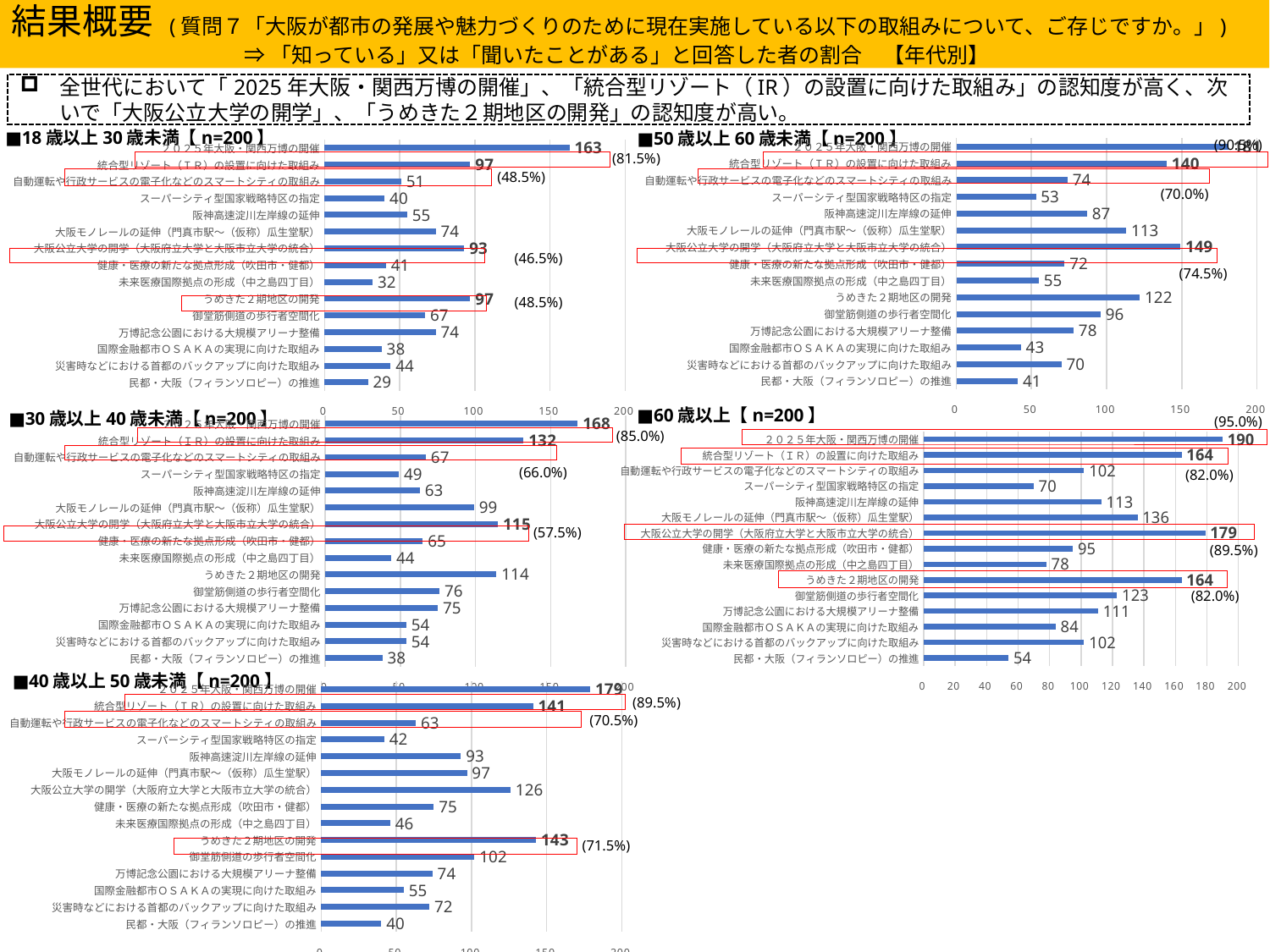
In the 「30歳以上40歳未満」 chart, what is the difference between 「2025年大阪・関西万博の開催」 and 「大阪公立大学の開学（大阪府立大学と大阪市立大学の統合）」? 53 In the 「40歳以上50歳未満」 chart, which is larger: 「阪神高速淀川左岸線の延伸」 or 「大阪モノレールの延伸（門真市駅～（仮称）瓜生堂駅）」? 大阪モノレールの延伸（門真市駅～（仮称）瓜生堂駅） In the 「50歳以上60歳未満」 chart, which category has the highest value? 2025年大阪・関西万博の開催 In the 「30歳以上40歳未満」 chart, what is the value for 「統合型リゾート（ＩＲ）の設置に向けた取組み」? 132 How many categories are plotted in the 「60歳以上」 chart? 15 In the 「18歳以上30歳未満」 chart, which category has the lowest value? 民都・大阪（フィランソロピー）の推進 In the 「50歳以上60歳未満」 chart, what is the value for 「大阪公立大学の開学（大阪府立大学と大阪市立大学の統合）」? 149 In the 「40歳以上50歳未満」 chart, what is the value for 「うめきた２期地区の開発」? 143 What type of chart is used for the 「18歳以上30歳未満」 age group? Bar chart In the 「60歳以上」 chart, what is the value for 「2025年大阪・関西万博の開催」? 190 In the 「60歳以上」 chart, what is the difference between 「統合型リゾート（ＩＲ）の設置に向けた取組み」 and 「民都・大阪（フィランソロピー）の推進」? 110 In the 「18歳以上30歳未満」 chart, what is the value for 「2025年大阪・関西万博の開催」? 163